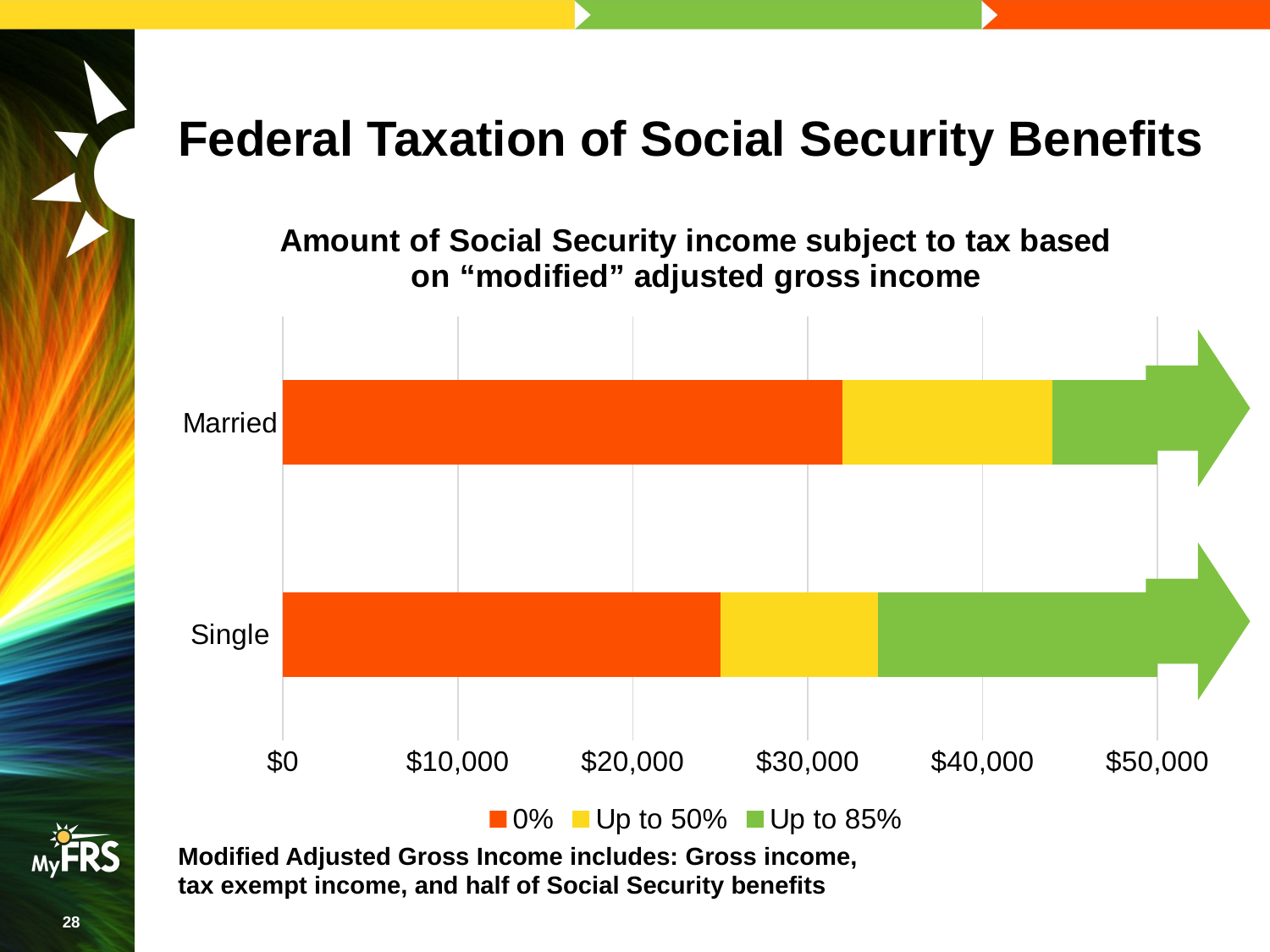
Which category has the longer 0% segment, Married or Single? Married What is the title of the chart? Amount of Social Security income subject to tax based on "modified" adjusted gross income What are the three series named in the chart's legend? 0%, Up to 50%, Up to 85% Is the end of the Up to 50% segment for Married greater or less than $40,000? greater Is the end of the 0% segment for Married greater or less than $30,000? greater What is the highest value labelled on the horizontal axis of the chart? $50,000 How many categories are plotted on the vertical axis of the chart? 2 What kind of chart is shown on the slide? Stacked bar chart How many series does the chart's legend list? 3 Is the end of the 0% segment for Single greater or less than $20,000? greater